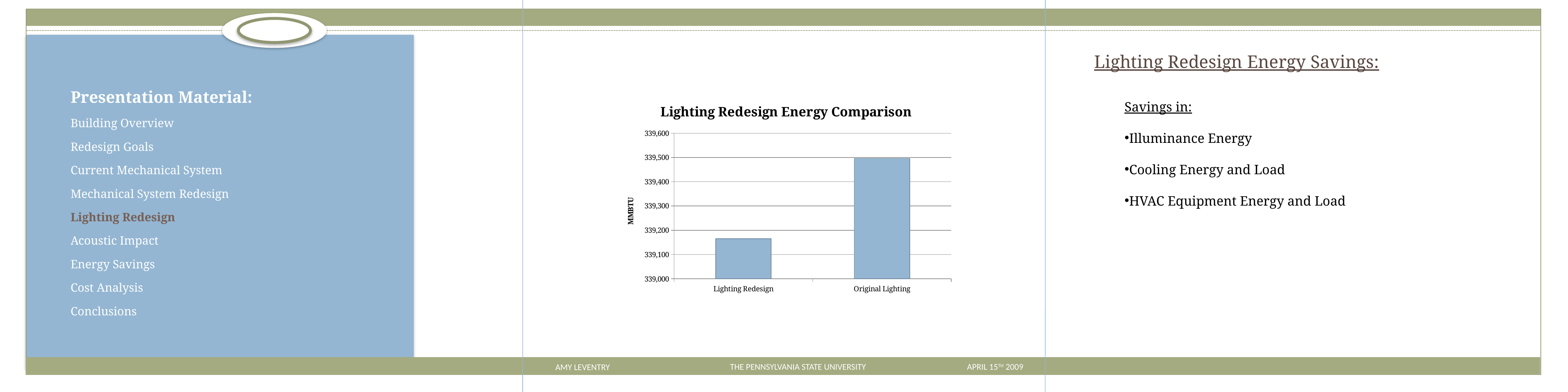
Is the value for Original Lighting greater or less than 339,600? less Is the value for Lighting Redesign greater or less than 339,200? less What is the title of the chart? Lighting Redesign Energy Comparison Is the value for Lighting Redesign greater or less than 339,100? greater What kind of chart is shown on the slide? bar chart How many categories are plotted in the chart? 2 Which is larger, the value for Lighting Redesign or the value for Original Lighting? Original Lighting What unit is shown on the vertical axis of the chart? MMBTU Which category has the lowest value in the chart? Lighting Redesign Do the values rise or fall from left to right across the categories? rise Which category has the highest value in the chart? Original Lighting